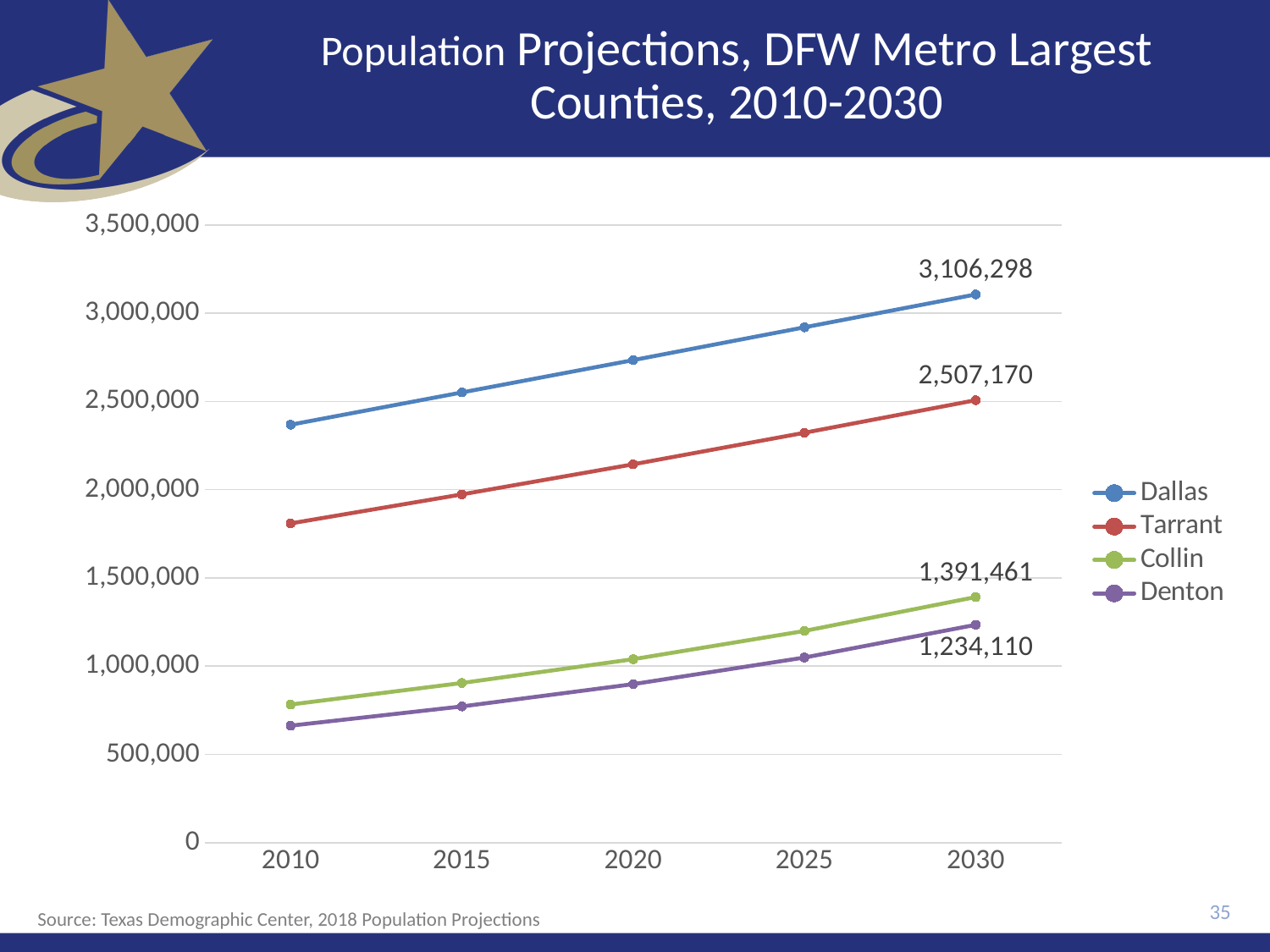
What is the projected population of Dallas County in 2030? 3,106,298 Which county has the lowest projected population in 2030? Denton Is the value for Denton in 2010 greater or less than 1,000,000? less Is the value for Dallas in 2010 greater or less than 2,000,000? greater What is the projected population of Denton County in 2030? 1,234,110 What is the projected population of Tarrant County in 2030? 2,507,170 What is the difference between the 2030 projected populations of Collin and Denton counties? 157,351 How many series does the legend list? 4 Which county has the highest projected population in 2030? Dallas What kind of chart is shown on the slide? Line chart What is the difference between the 2030 projected populations of Dallas and Tarrant counties? 599,128 What is the projected population of Collin County in 2030? 1,391,461